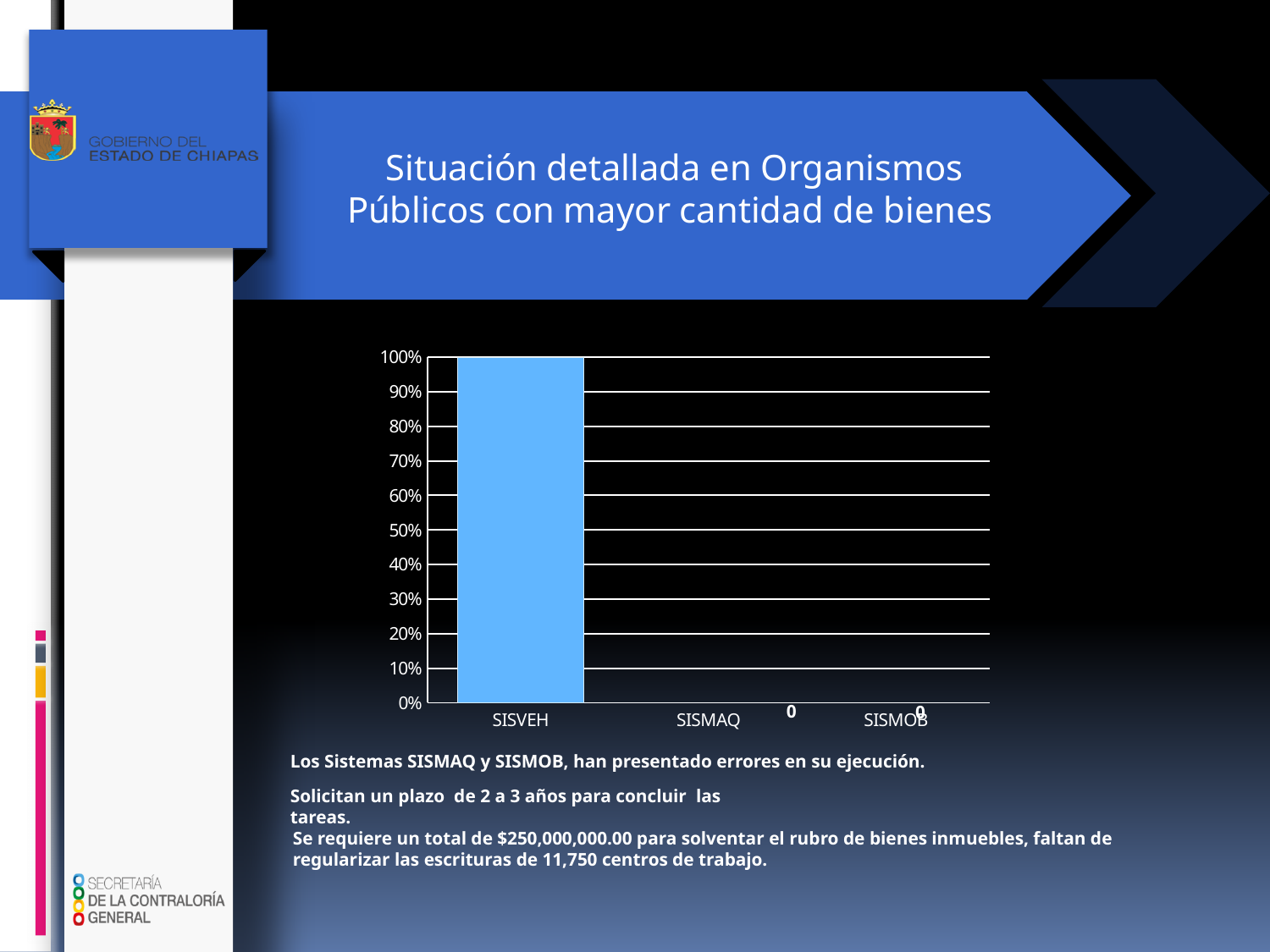
What kind of chart is shown on the slide? bar chart What colour is the SISVEH bar in the chart? light blue What data label is shown for SISMOB in the chart? 0 Is the value for SISVEH greater or less than 50%? greater Which category has the highest value in the chart? SISVEH Which is larger, the value for SISVEH or the value for SISMOB? SISVEH Which is larger, the value for SISVEH or the value for SISMAQ? SISVEH What is the highest tick value shown on the y axis of the chart? 100% What is the value for SISVEH in the chart? 100% How many categories are shown on the x axis of the chart? 3 Do the values rise or fall from SISVEH to SISMOB along the x axis? fall What data label is shown for SISMAQ in the chart? 0